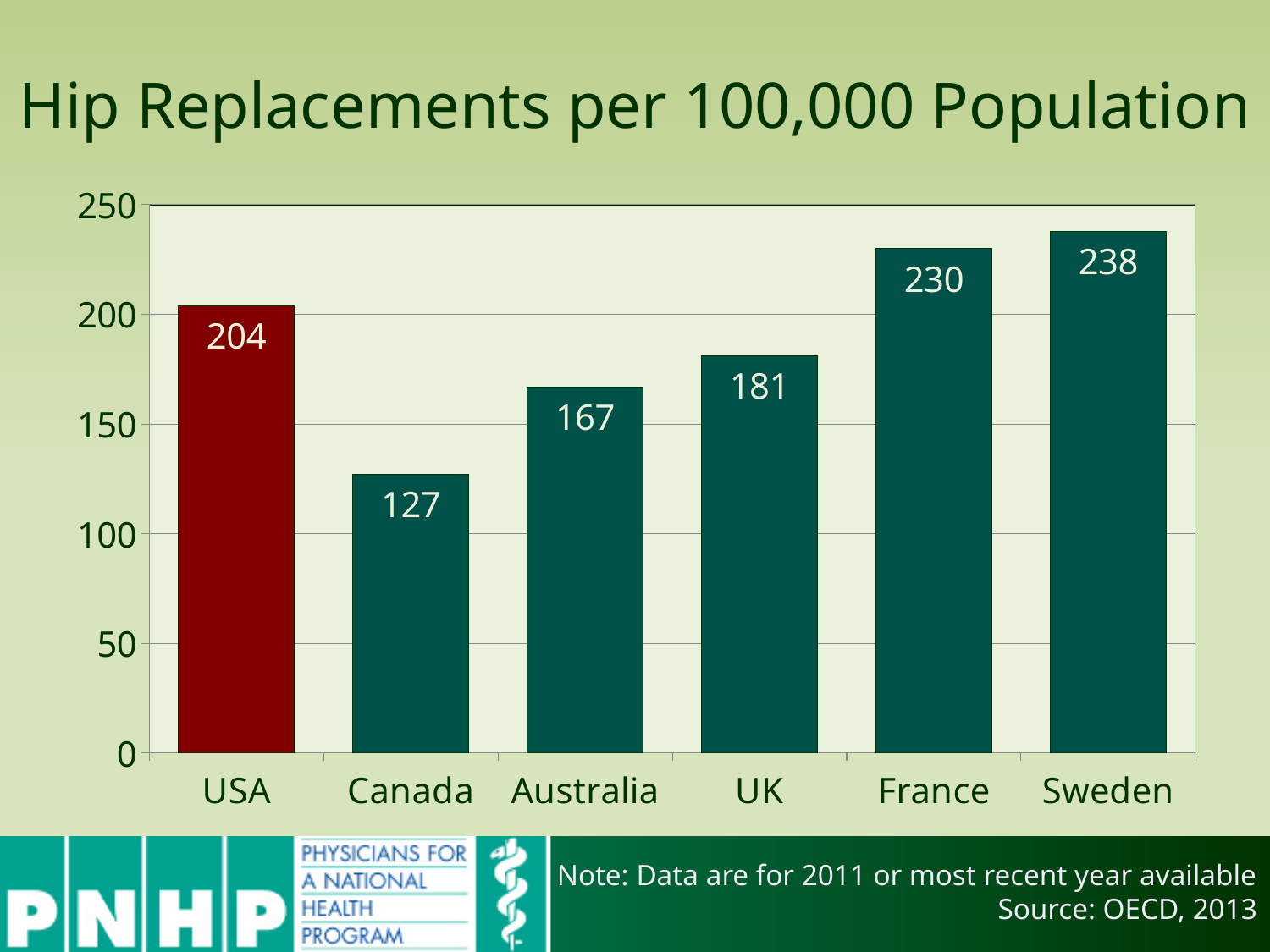
What is the value for the USA? 204 What is the difference between the values for the UK and Australia? 14 Is the value for Australia greater or less than 150? greater What is the difference between the values for Sweden and the USA? 34 What is the value for France? 230 How many countries are shown in the chart? 6 Which country has the highest number of hip replacements per 100,000 population? Sweden Which country has the lowest number of hip replacements per 100,000 population? Canada What is the value for Canada? 127 What kind of chart is shown on the slide? Bar chart Which is larger, the value for the USA or the value for the UK? USA Which bar is shown in a different colour (dark red) from the others? USA